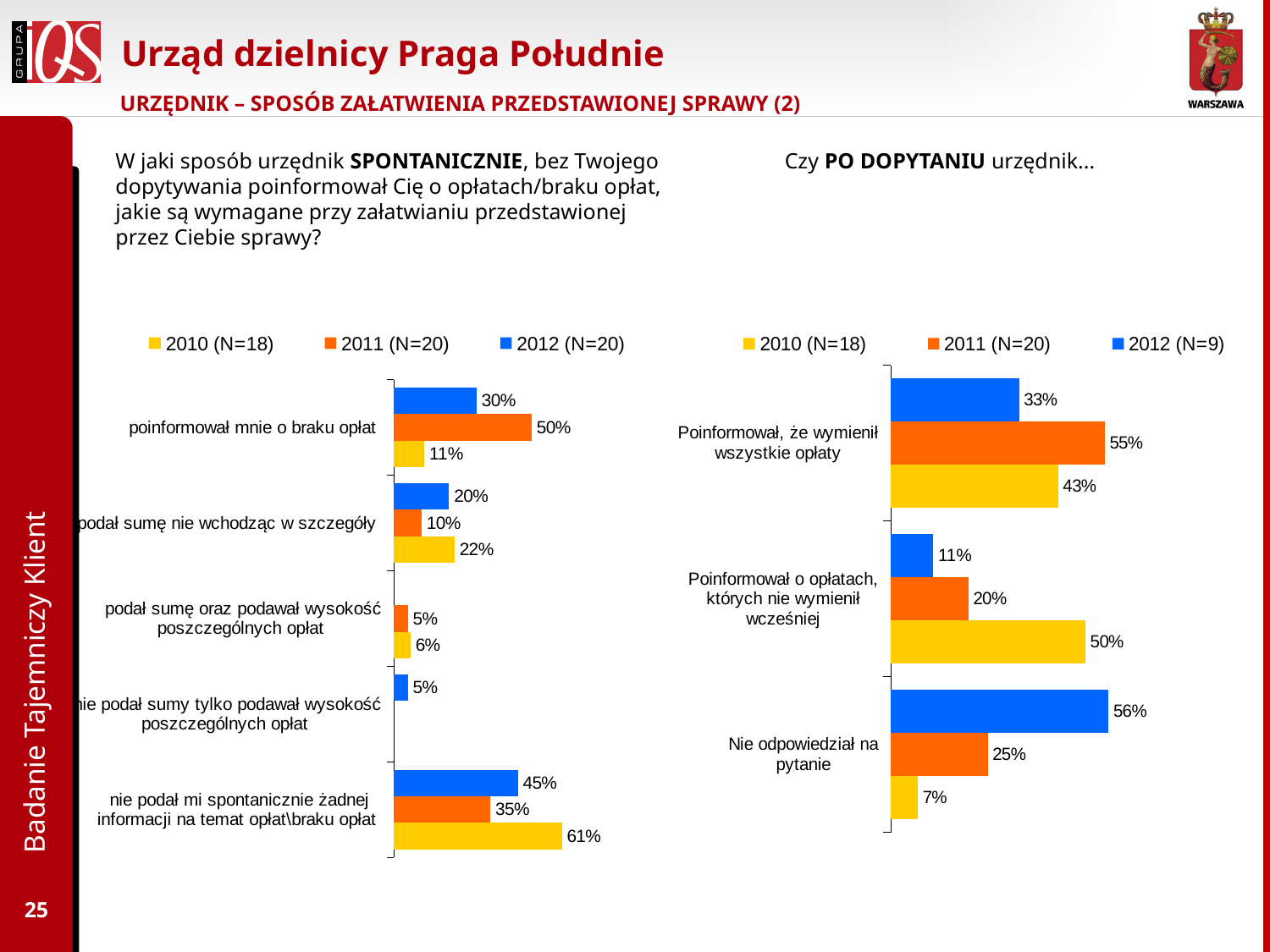
What type of chart is the right chart? Bar chart In the right chart, what is the 2010 (N=18) value for "Poinformował o opłatach, których nie wymienił wcześniej"? 50% In the right chart, what is the 2012 (N=9) value for "Nie odpowiedział na pytanie"? 56% How many categories are shown in the right chart? 3 In the left chart, what is the 2011 (N=20) value for "poinformował mnie o braku opłat"? 50% How many series does the legend of the left chart list? 3 In the right chart, which category has the highest 2011 (N=20) value? Poinformował, że wymienił wszystkie opłaty In the right chart, what is the difference between the 2012 and 2010 values for "Nie odpowiedział na pytanie"? 49% In the left chart, what is the 2010 (N=18) value for "nie podał mi spontanicznie żadnej informacji na temat opłat\braku opłat"? 61% In the left chart, what is the difference between the 2011 and 2012 values for "poinformował mnie o braku opłat"? 20% In the left chart, which is larger for "podał sumę nie wchodząc w szczegóły": the 2010 value or the 2011 value? 2010